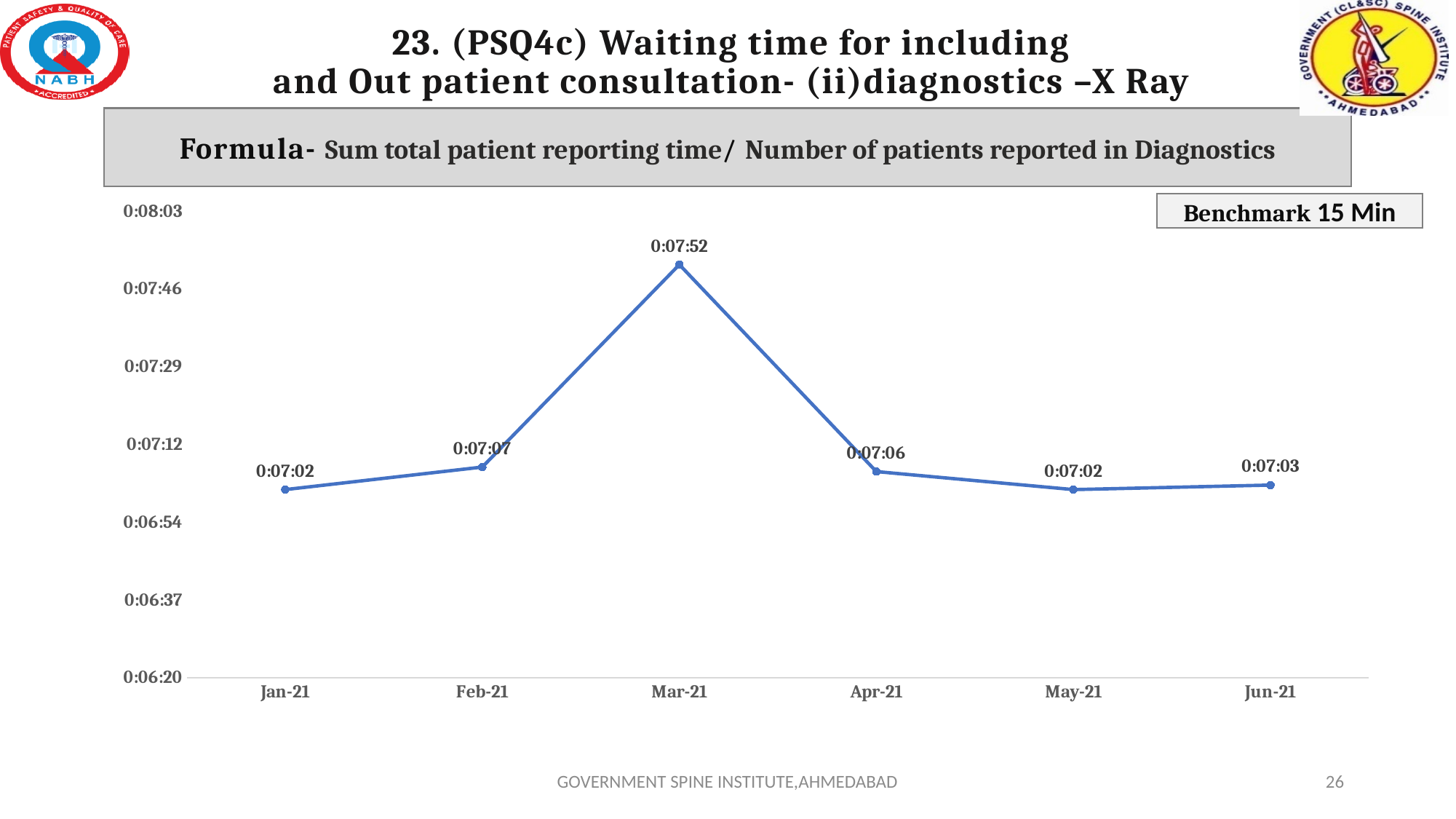
What benchmark is stated on the slide? 15 Min What is the value for Jun-21? 0:07:03 By how many seconds does the Mar-21 value exceed the Feb-21 value? 45 seconds Do the values rise or fall from Mar-21 to May-21? fall What kind of chart is shown on the slide? line chart What is the value for Mar-21? 0:07:52 What is the value for Jan-21? 0:07:02 Is the value for Mar-21 greater or less than 0:07:29? greater Which is larger, the value for Feb-21 or the value for Jun-21? Feb-21 What is the value for Apr-21? 0:07:06 How many months are plotted on the x axis? 6 Which month has the highest value? Mar-21